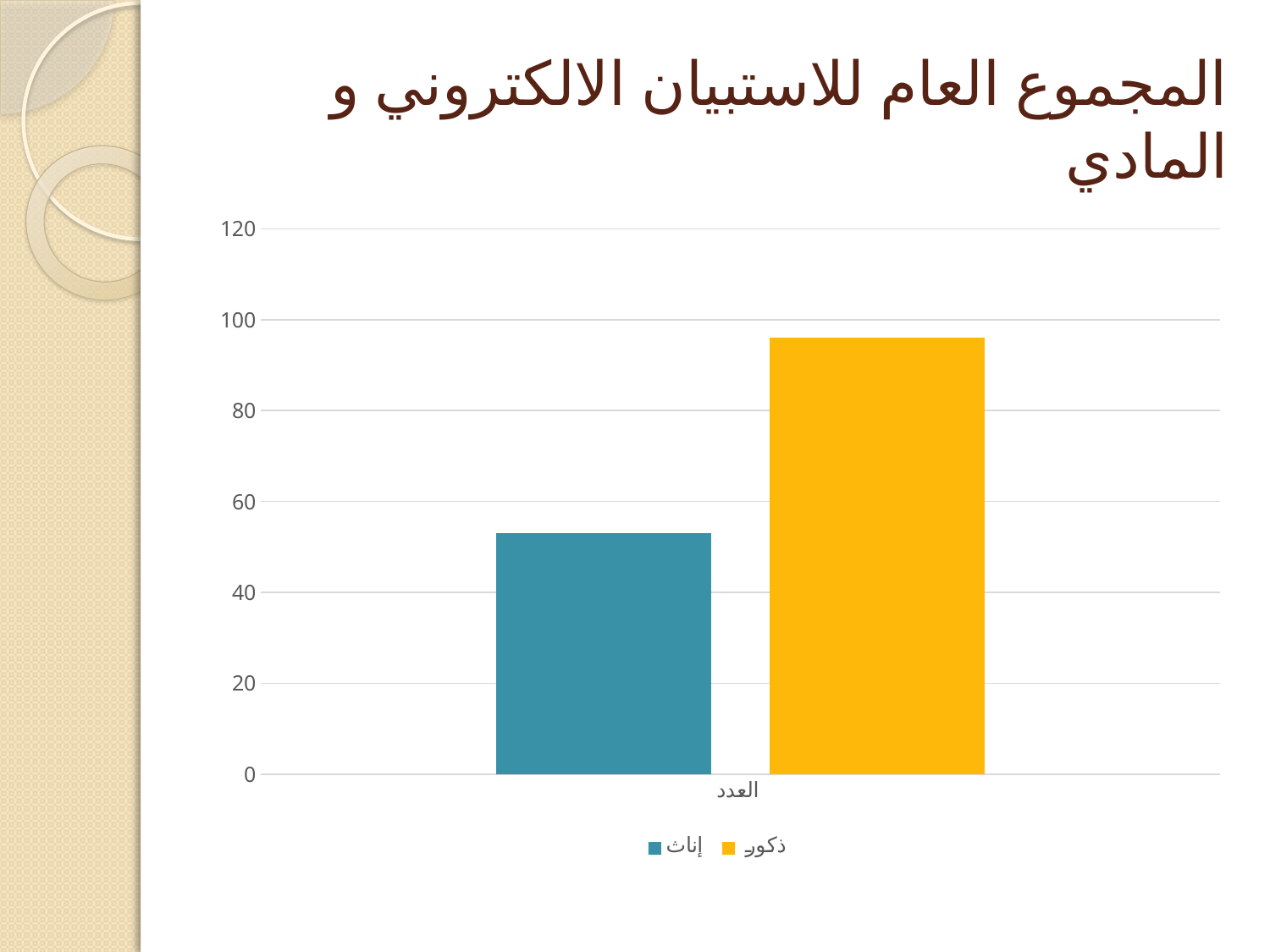
Is the bar for ذكور larger or smaller than the bar for إناث? larger What kind of chart is shown on the slide? bar chart Which series has the shorter bar, ذكور or إناث? إناث Which series has the taller bar, ذكور or إناث? ذكور How many categories are shown on the x axis? 1 What is the label of the category on the x axis? العدد Is the value for إناث greater or less than 40? greater Is the value for ذكور greater or less than 80? greater Which series is shown in orange? ذكور Is the value for إناث greater or less than 60? less How many series does the legend list? 2